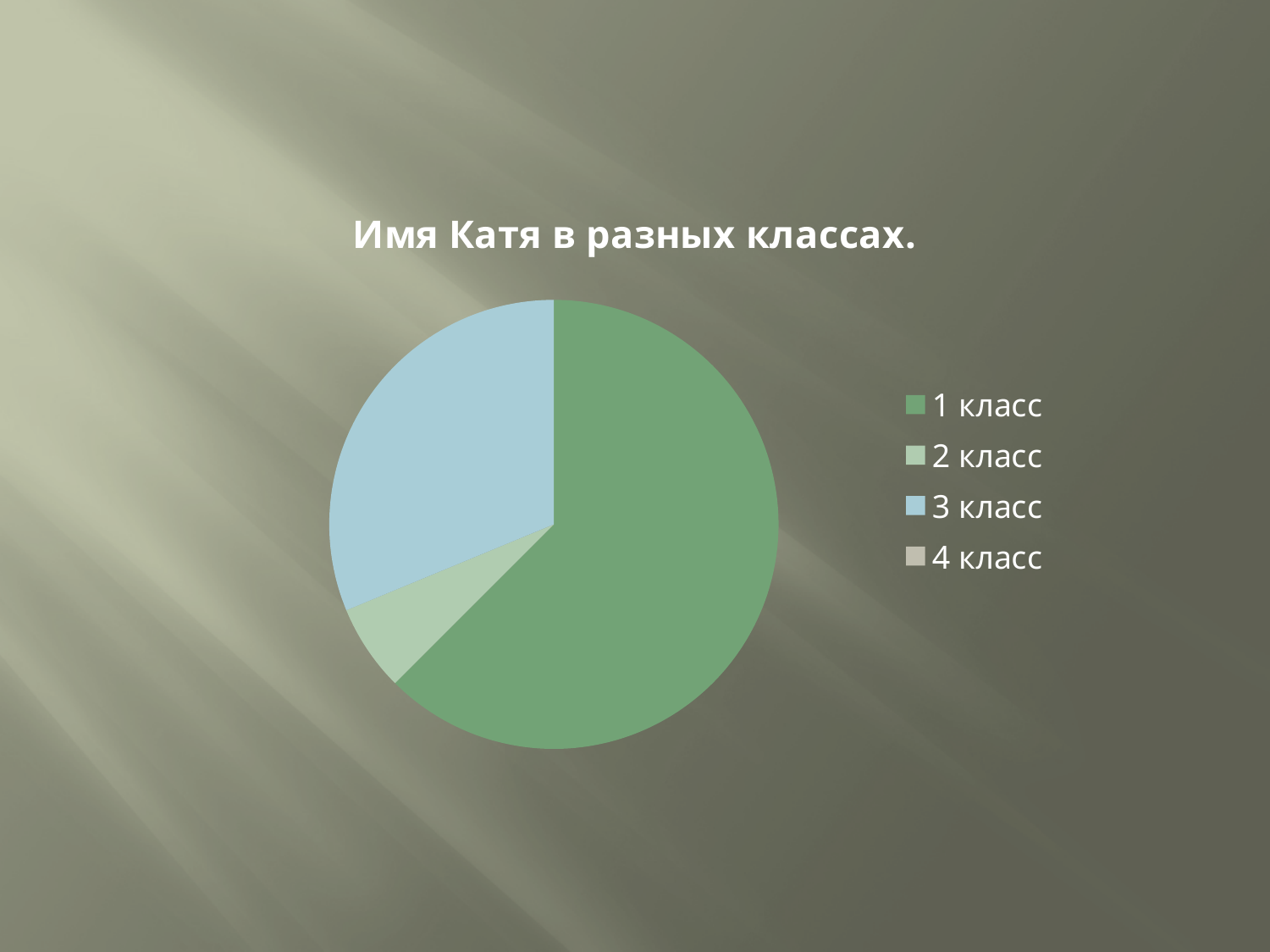
Which is larger, the slice for 1 класс or the slice for 3 класс? 1 класс Which is smaller, the slice for 1 класс or the slice for 2 класс? 2 класс Which is larger, the slice for 2 класс or the slice for 3 класс? 3 класс Does the slice for 1 класс take up more or less than half of the pie? more What is the title of the chart? Имя Катя в разных классах. What kind of chart is shown on the slide? pie chart How many categories does the legend list? 4 Which legend entry is shown in light blue? 3 класс Which category has the largest slice of the pie? 1 класс